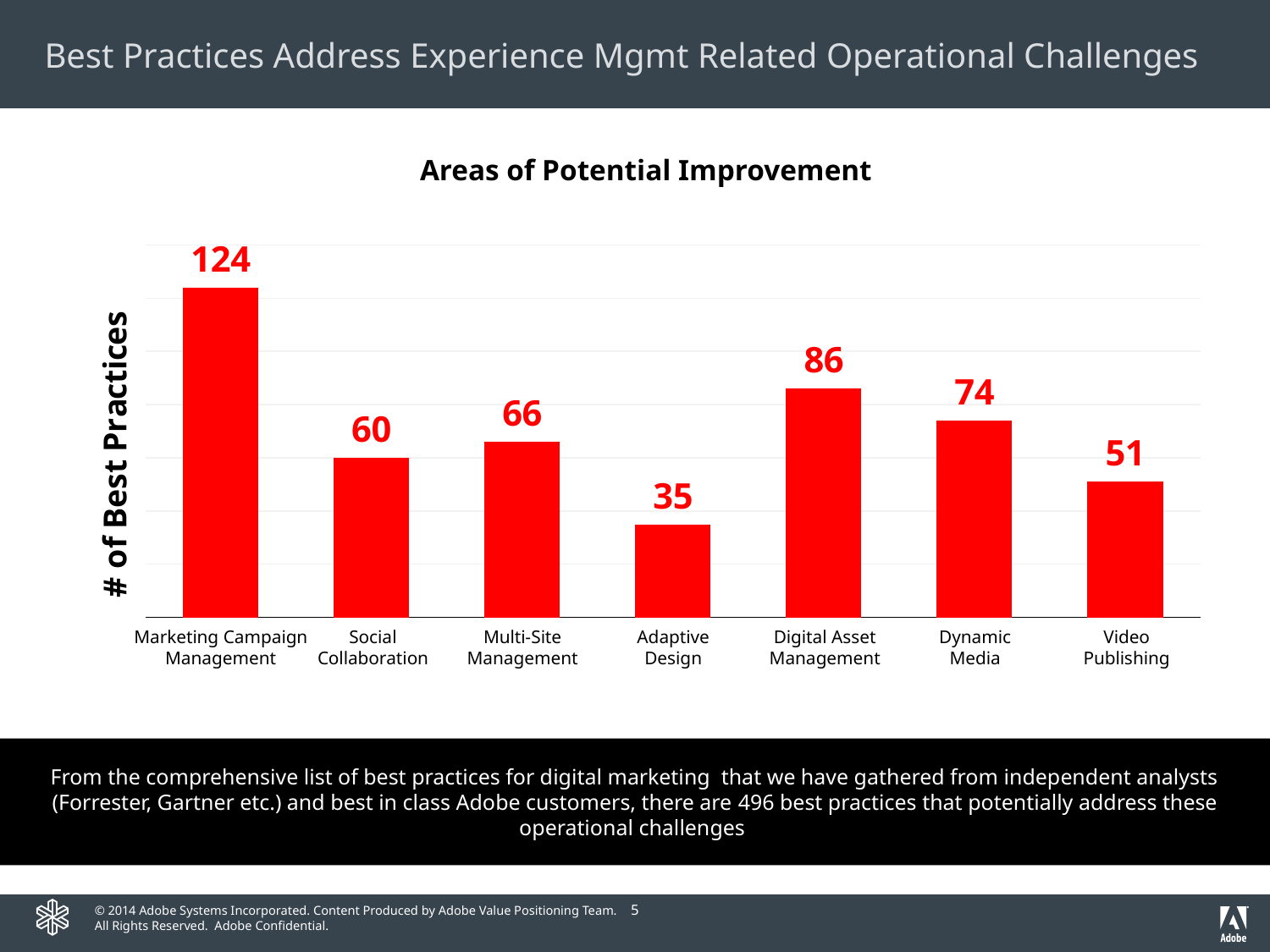
What is the difference between the values for Dynamic Media and Social Collaboration? 14 What is the number of best practices for Digital Asset Management? 86 What is the number of best practices for Video Publishing? 51 What is the number of best practices for Adaptive Design? 35 Which category has the highest number of best practices? Marketing Campaign Management What kind of chart is shown on the slide? Bar chart Which has a larger value, Multi-Site Management or Social Collaboration? Multi-Site Management What is the title of the chart? Areas of Potential Improvement What is the number of best practices for Marketing Campaign Management? 124 How many categories are shown in the chart? 7 What is the difference between the values for Marketing Campaign Management and Digital Asset Management? 38 Which category has the lowest number of best practices? Adaptive Design